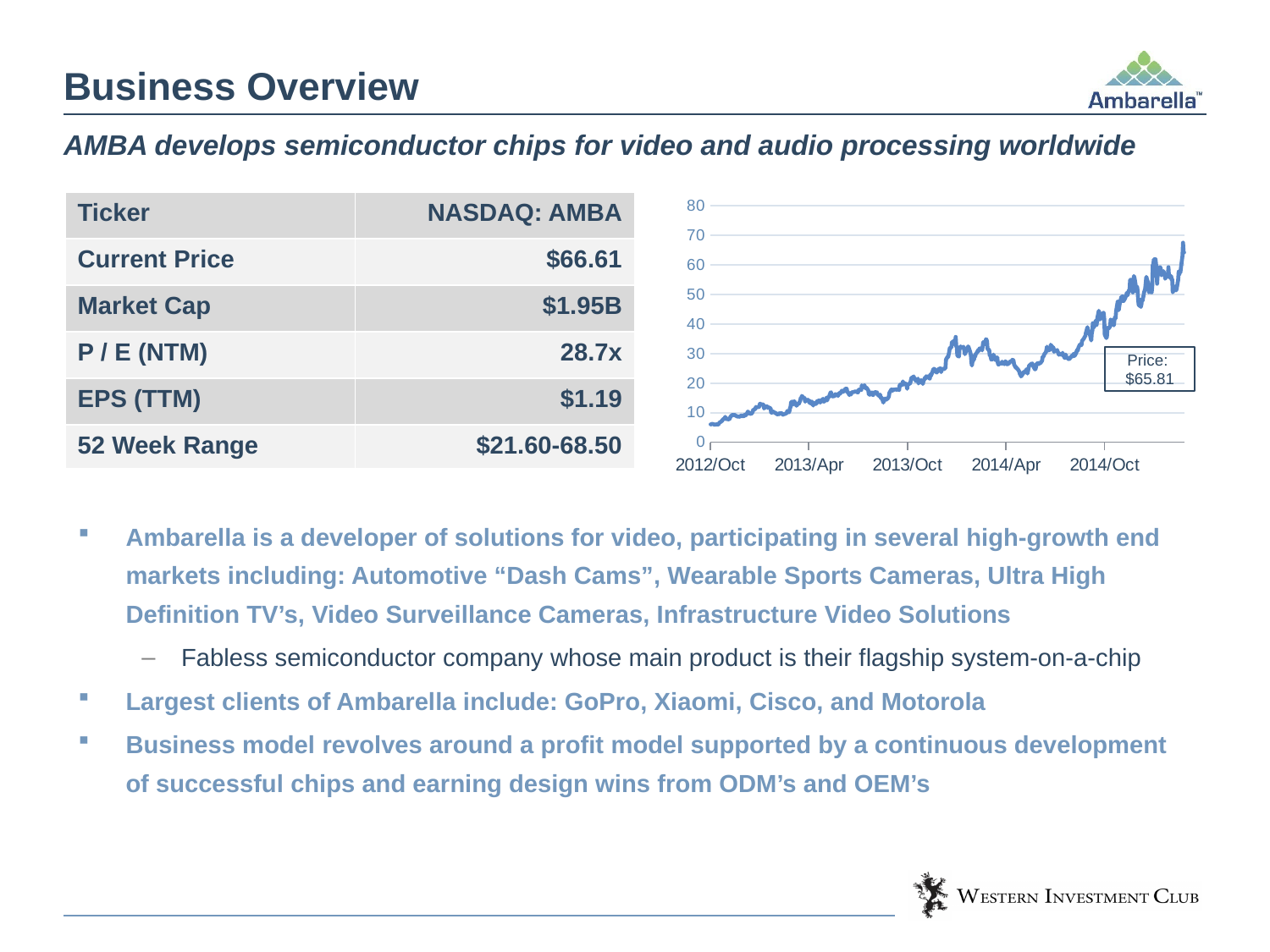
How many date labels are shown on the x axis of the line chart? 5 Is the value at 2013/Apr in the line chart greater or less than 30? less Is the value at 2012/Oct in the line chart greater or less than 20? less Is the value at 2014/Apr in the line chart greater or less than 50? less What is the highest value shown on the y axis of the line chart? 80 In the line chart, is the value at 2014/Oct larger or smaller than the value at 2013/Oct? larger What is the first date label on the x axis of the line chart? 2012/Oct Do the values in the line chart generally rise or fall from 2012/Oct to the end of the series? rise What price is shown in the data label at the end of the line chart? $65.81 What kind of chart is shown on the right of the slide? line chart Around which x-axis label does the line chart reach its lowest values? 2012/Oct